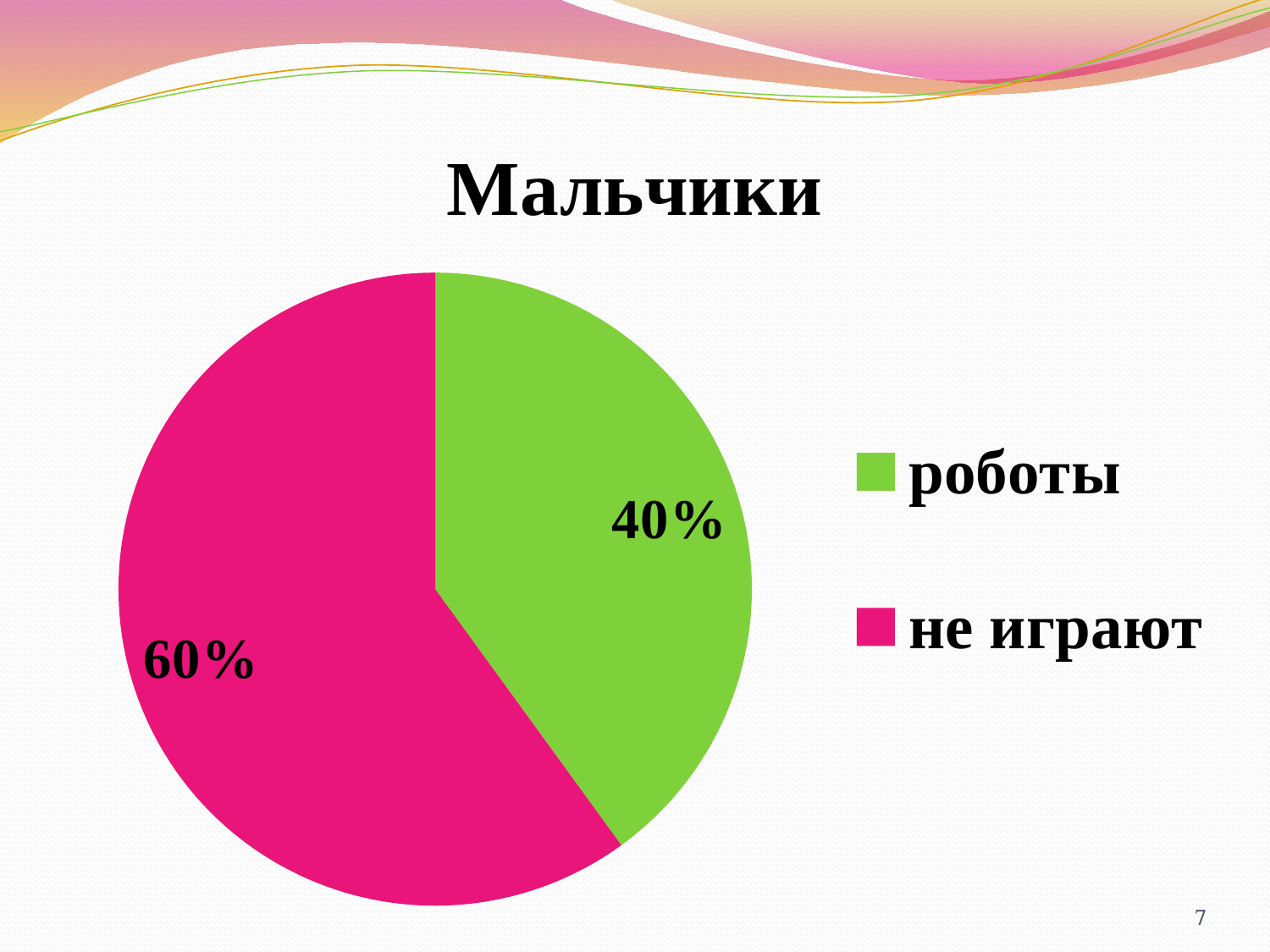
Which slice is the smallest? роботы What kind of chart is shown on the slide? pie chart What share of the pie does the "не играют" slice represent? 60% How many entries does the legend list? 2 Which is larger, the "роботы" slice or the "не играют" slice? не играют What colour is the "роботы" slice? green What is the title of the chart? Мальчики Which slice is the largest? не играют Is the share for "роботы" greater or less than 50%? less What is the difference between the "не играют" and "роботы" shares? 20% What share of the pie does the "роботы" slice represent? 40% How many slices does the pie chart have? 2